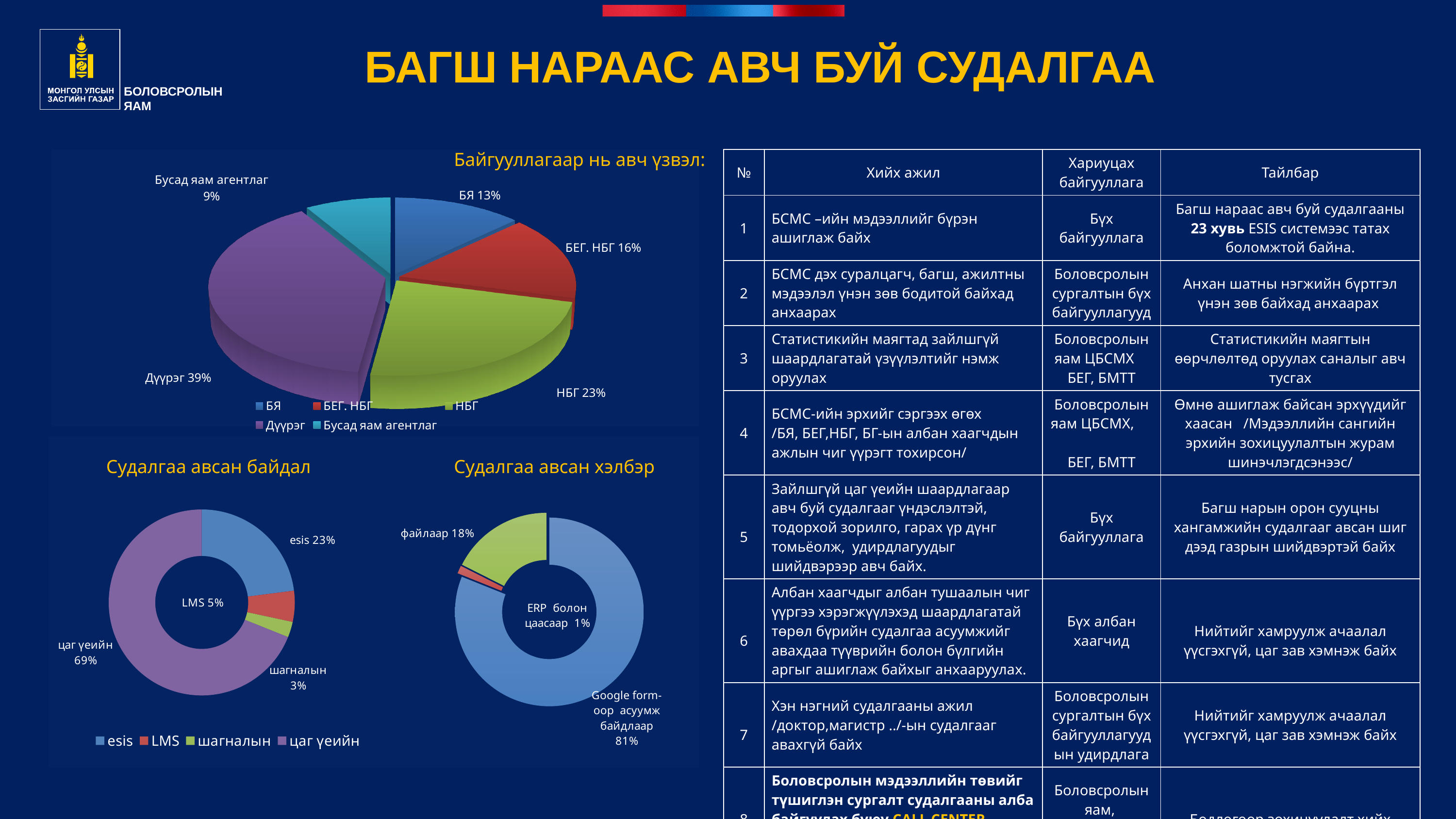
In the chart titled "Байгууллагаар нь авч үзвэл:", what is the difference in percentage points between Дүүрэг and БЯ? 26 In the chart titled "Байгууллагаар нь авч үзвэл:", which category has the smallest share? Бусад яам агентлаг In the chart titled "Байгууллагаар нь авч үзвэл:", how many categories are shown? 5 In the chart titled "Байгууллагаар нь авч үзвэл:", which category has the largest share? Дүүрэг In the chart titled "Судалгаа авсан байдал", which is larger, esis or LMS? esis In the chart titled "Байгууллагаар нь авч үзвэл:", what share does НБГ have? 23% In the chart titled "Судалгаа авсан хэлбэр", which category has the largest share? Google form-оор асуумж байдлаар What kind of chart is the one titled "Байгууллагаар нь авч үзвэл:"? Pie chart In the chart titled "Судалгаа авсан хэлбэр", what share does файлаар have? 18% In the chart titled "Байгууллагаар нь авч үзвэл:", what share does Дүүрэг have? 39% In the chart titled "Судалгаа авсан байдал", what share does цаг үеийн have? 69% In the chart titled "Судалгаа авсан байдал", which category has the smallest share? шагналын